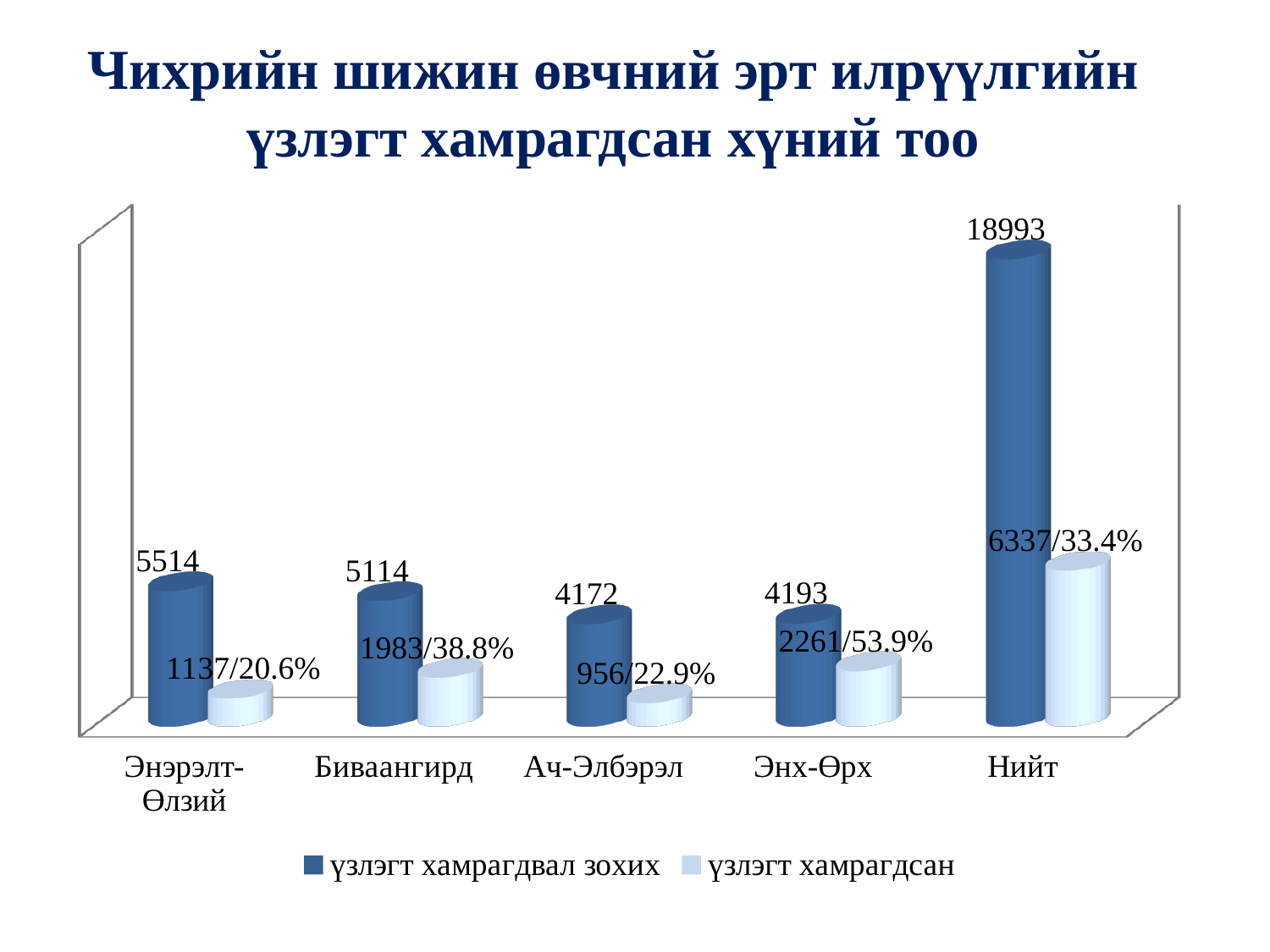
How many categories are shown on the x axis? 5 What is the difference between the "үзлэгт хамрагдвал зохих" values for Энэрэлт-Өлзий and Биваангирд? 400 What data label is shown for "үзлэгт хамрагдсан" for Ач-Элбэрэл? 956/22.9% Which category has the highest value for "үзлэгт хамрагдвал зохих"? Нийт Which is larger: the "үзлэгт хамрагдсан" count for Биваангирд or for Энэрэлт-Өлзий? Биваангирд What kind of chart is shown on the slide? Bar chart Excluding Нийт, which category has the lowest value for "үзлэгт хамрагдсан"? Ач-Элбэрэл How many series does the legend list? 2 What is the value of "үзлэгт хамрагдвал зохих" for Нийт? 18993 What is the value of "үзлэгт хамрагдвал зохих" for Энэрэлт-Өлзий? 5514 What percentage is shown for "үзлэгт хамрагдсан" for Нийт? 33.4% What data label is shown for "үзлэгт хамрагдсан" for Энх-Өрх? 2261/53.9%